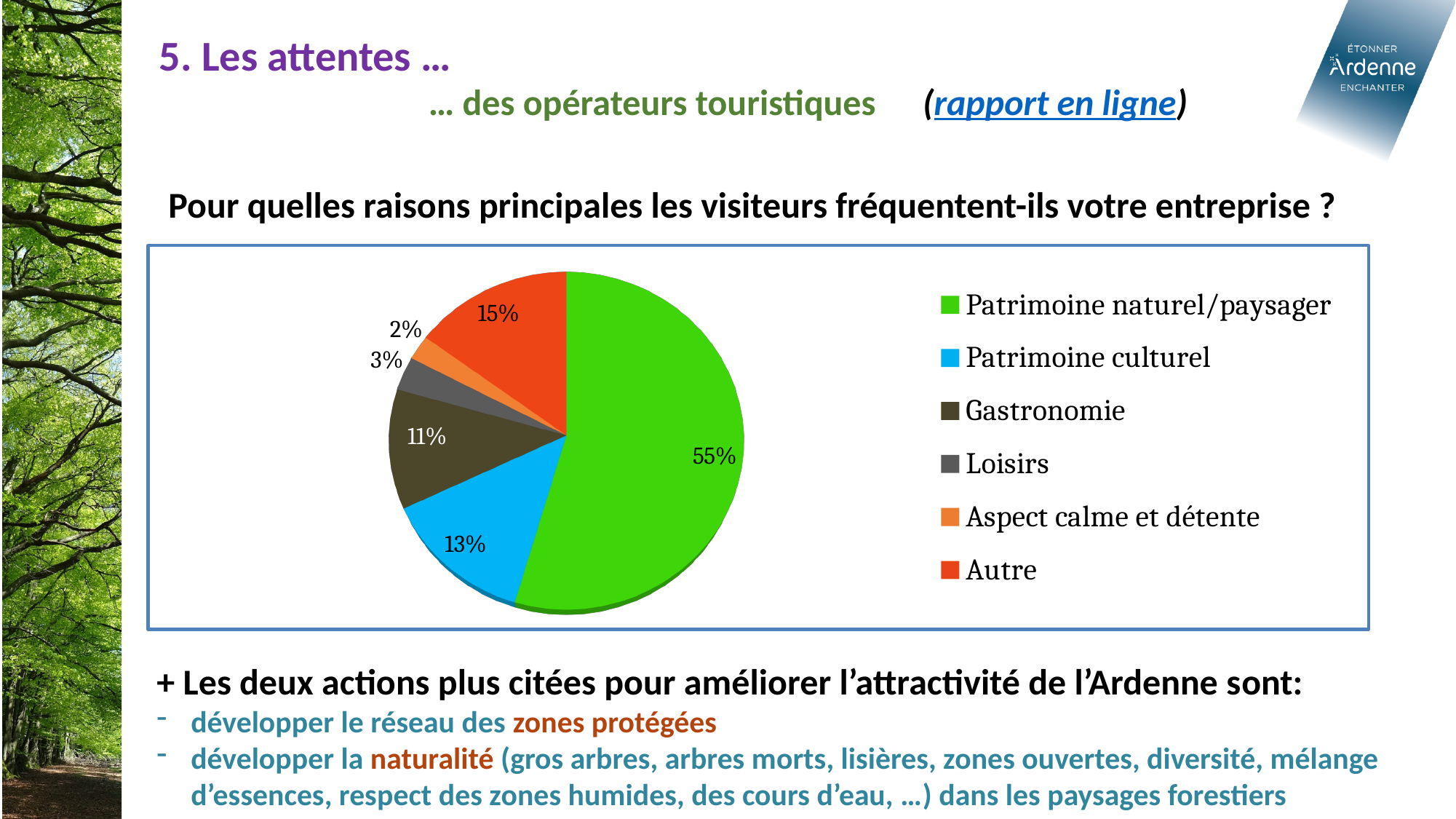
What percentage is shown for Loisirs? 3% How many categories does the pie chart show? 6 Which is larger, the slice for Autre or the slice for Gastronomie? Autre What percentage is shown for Gastronomie? 11% What colour is the slice for Patrimoine culturel? Blue What is the difference in percentage points between Patrimoine naturel/paysager and Patrimoine culturel? 42 What percentage is shown for Patrimoine culturel? 13% What share of the pie does Patrimoine naturel/paysager represent? 55% Which category has the smallest slice of the pie? Aspect calme et détente Which category has the largest slice of the pie? Patrimoine naturel/paysager What percentage is shown for Autre? 15% What kind of chart is shown on the slide? Pie chart